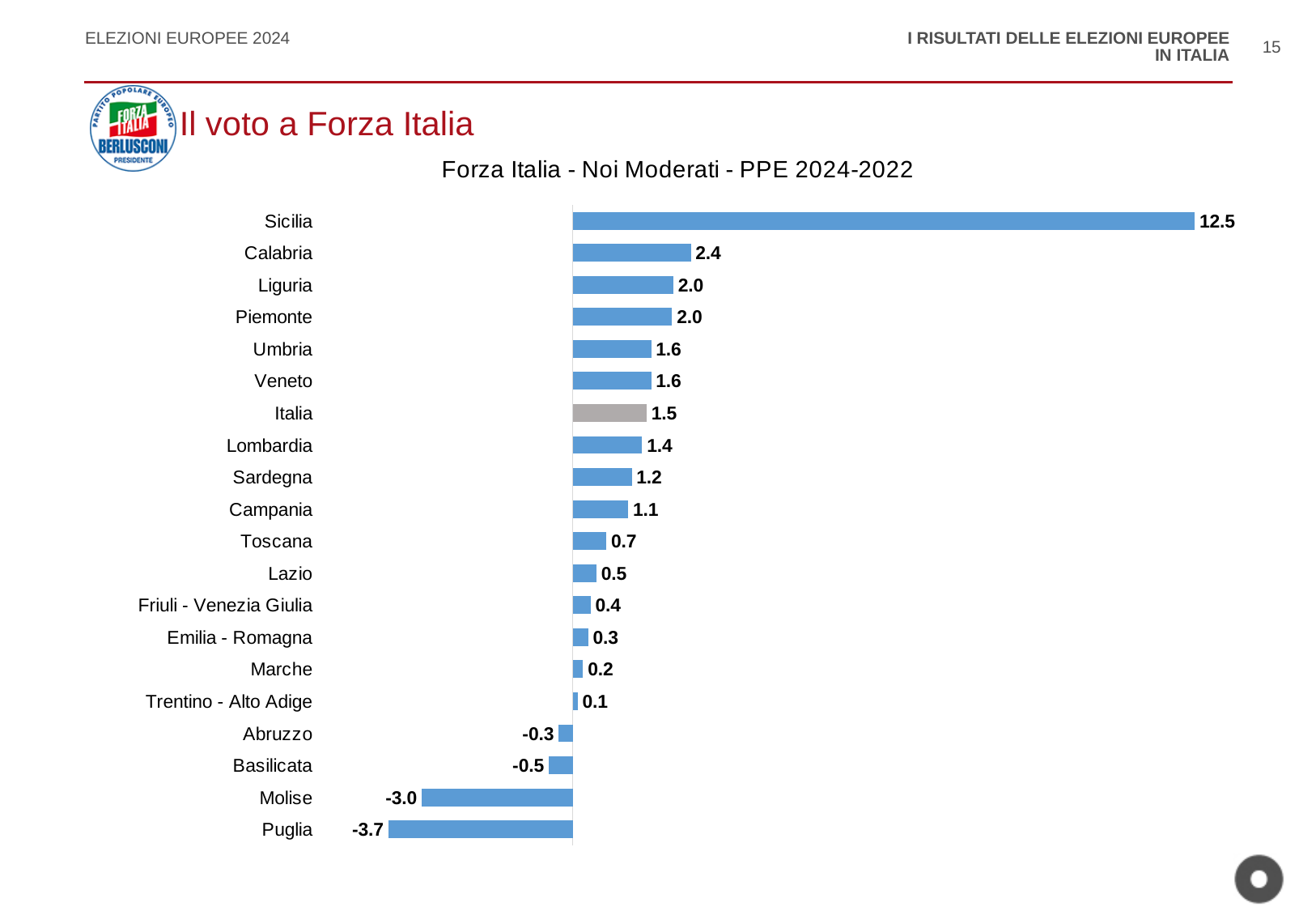
What is the difference between the values for Sicilia and Calabria? 10.1 Which region has the highest value? Sicilia What is the value for Sicilia? 12.5 Which bar is coloured grey instead of blue? Italia What is the value for Puglia? -3.7 What is the difference between the values for Molise and Puglia? 0.7 What is the title of the chart? Forza Italia - Noi Moderati - PPE 2024-2022 What is the value for Italia? 1.5 Which has a larger value, Lombardia or Campania? Lombardia Which region has the lowest value? Puglia How many regions (categories) are shown in the chart? 20 What kind of chart is shown on the slide? Bar chart